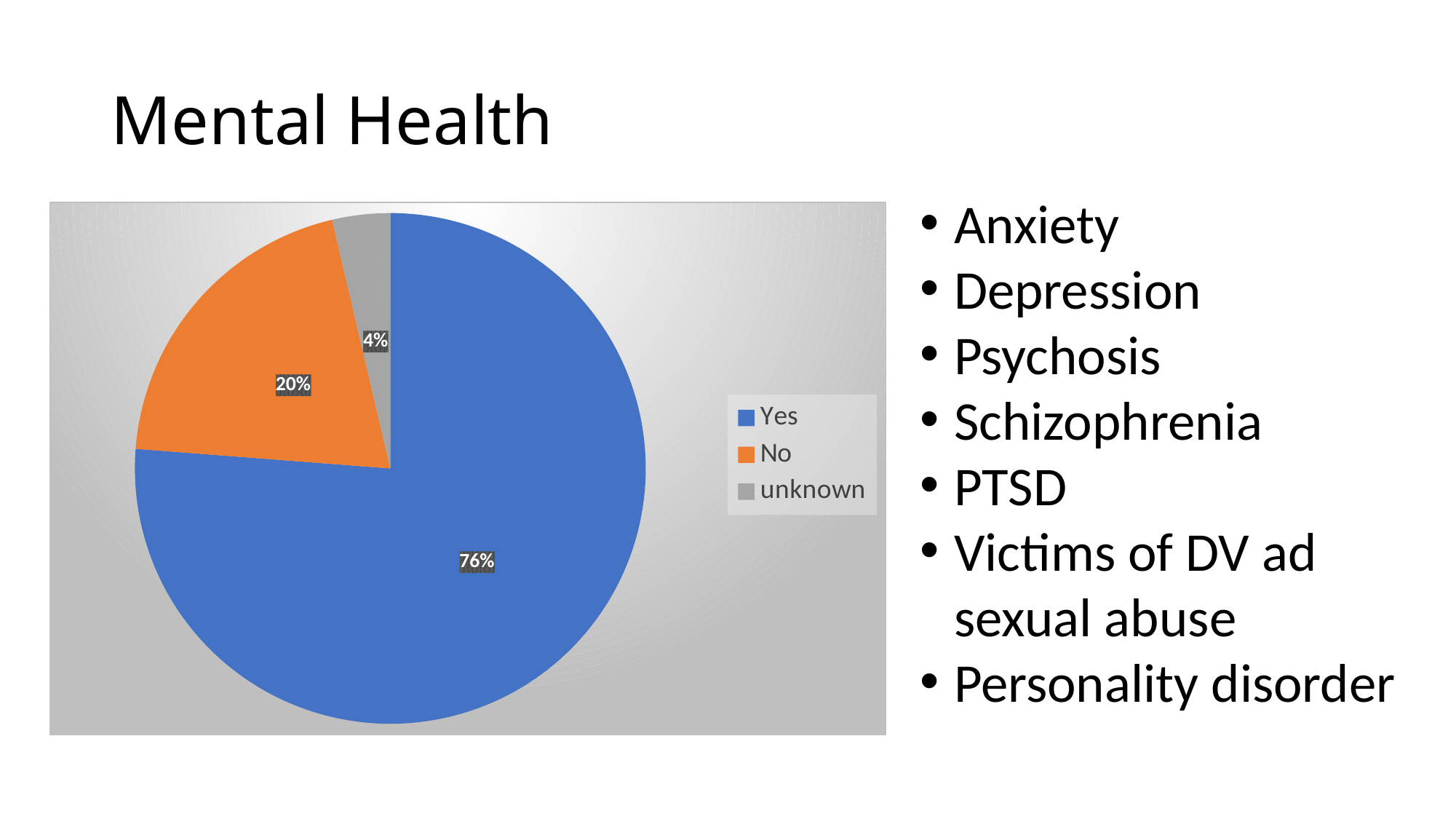
What percentage of the pie is labelled "unknown"? 4% What is the difference in percentage points between the "Yes" slice and the "No" slice? 56 What percentage of the pie is labelled "Yes"? 76% What colour is the "No" slice in the pie chart? orange Which category has the largest slice of the pie? Yes What is the difference in percentage points between the "No" slice and the "unknown" slice? 16 What percentage of the pie is labelled "No"? 20% Which category has the smallest slice of the pie? unknown How many entries does the legend list? 3 Which slice is larger, "No" or "unknown"? No What kind of chart is shown on the slide? pie chart How many slices does the pie chart have? 3